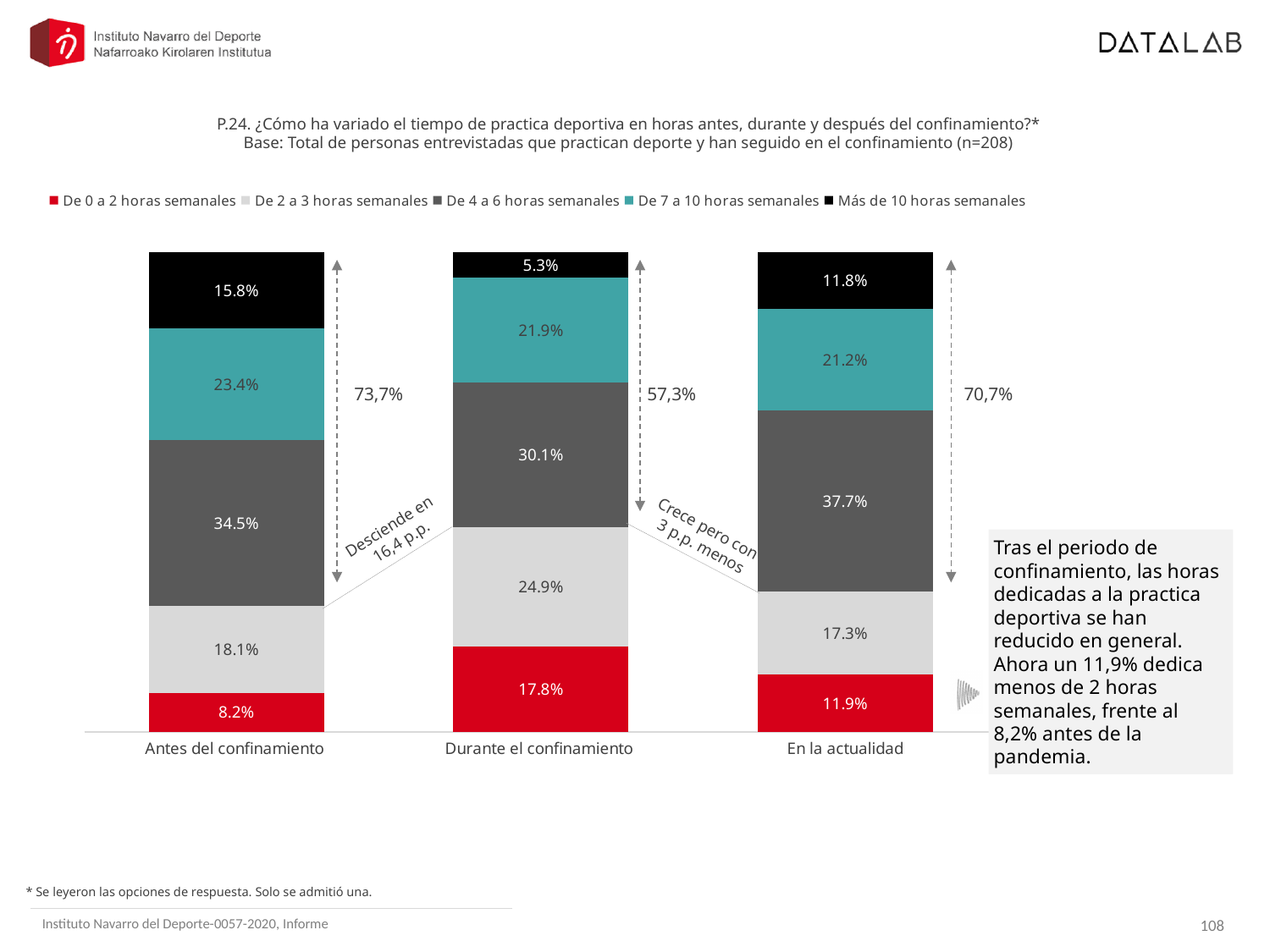
Which period has the lowest value for 'Más de 10 horas semanales'? Durante el confinamiento Which is larger: the 'De 7 a 10 horas semanales' value before the confinement or during the confinement? Antes del confinamiento What is the value for 'De 4 a 6 horas semanales' in the 'En la actualidad' bar? 37.7% How many periods (categories) are shown on the x axis? 3 What combined percentage is annotated next to the 'Antes del confinamiento' bar for the three upper segments? 73,7% What is the difference between the 'De 0 a 2 horas semanales' value in 'En la actualidad' and in 'Antes del confinamiento'? 3.7 percentage points How many series does the legend list? 5 What is the value for 'De 2 a 3 horas semanales' during the confinement? 24.9% What is the value for 'Más de 10 horas semanales' during the confinement (Durante el confinamiento)? 5.3% What percentage of respondents practised sport 'De 0 a 2 horas semanales' before the confinement (Antes del confinamiento)? 8.2% Which of the three periods has the highest value for 'De 0 a 2 horas semanales'? Durante el confinamiento What kind of chart is shown on the slide? Stacked bar chart